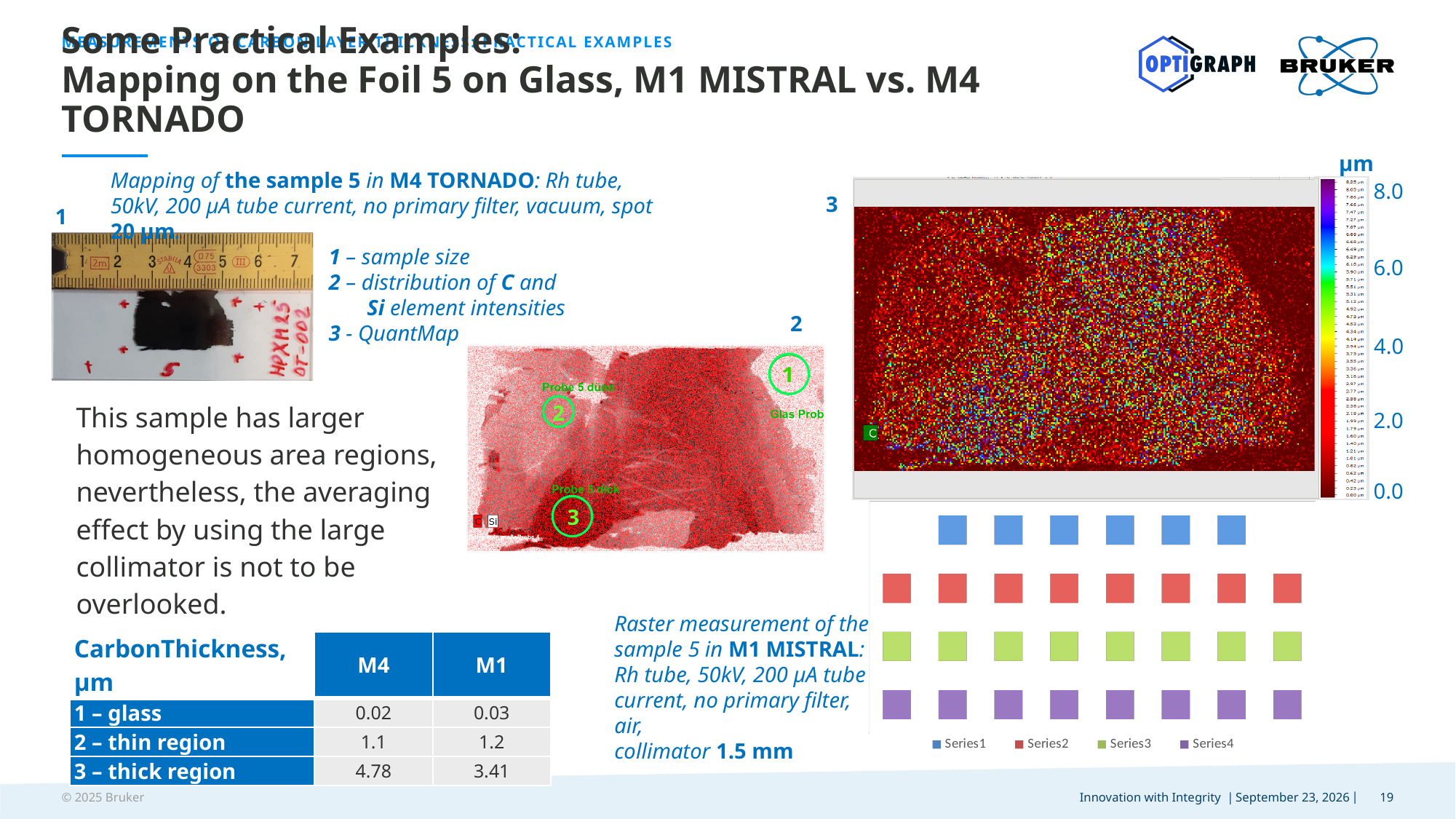
In the chart at the bottom right, how many markers are plotted for Series4? 8 What is the name of the first legend entry in the chart at the bottom right? Series1 In the chart at the bottom right, how many markers are plotted for Series2? 8 What colour are the Series2 markers in the chart at the bottom right? Red In the chart at the bottom right, which series has fewer plotted markers, Series1 or Series3? Series1 How many series does the legend of the chart at the bottom right list? 4 In the chart at the bottom right, how many markers are plotted for Series1? 6